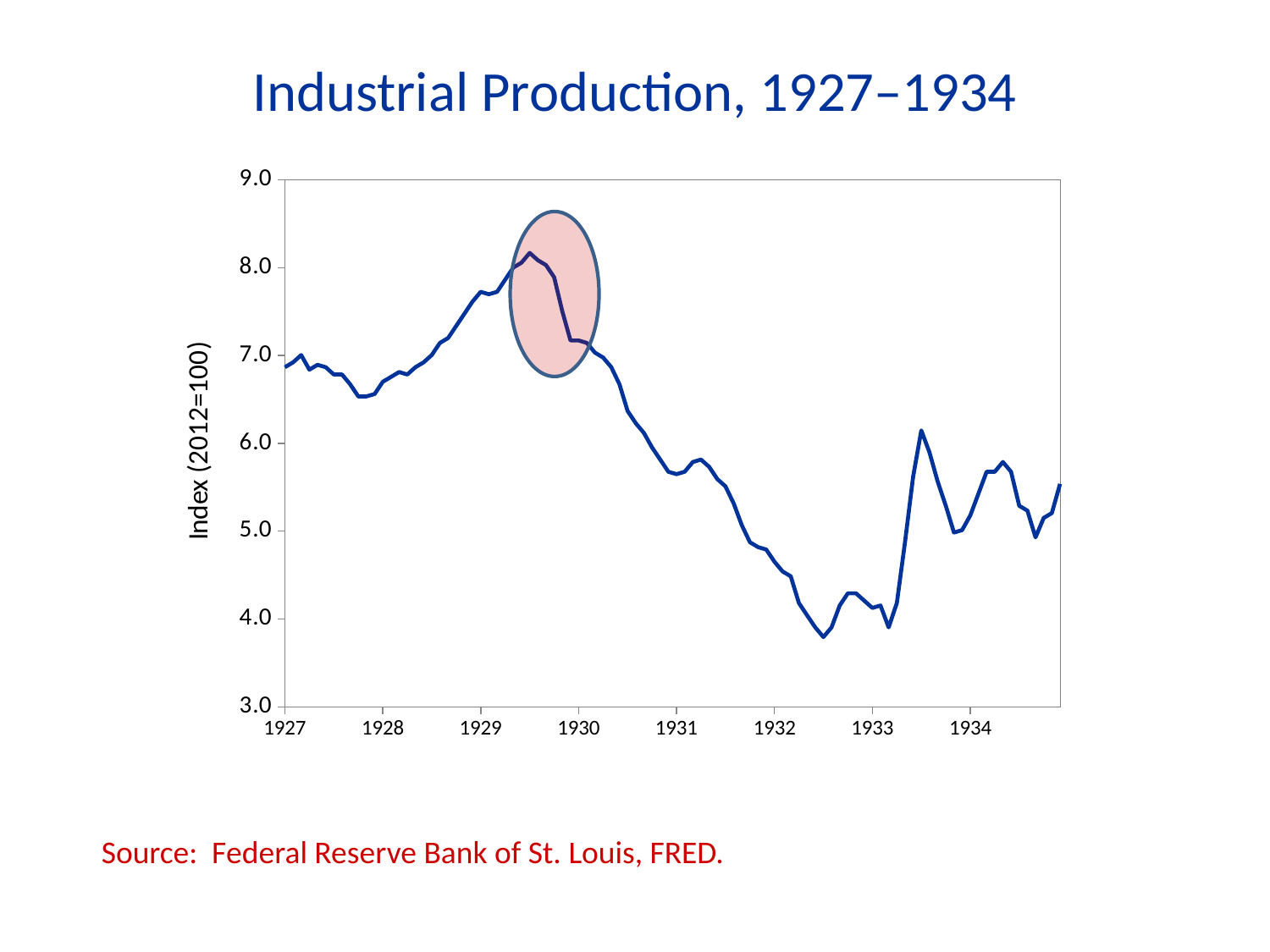
Is the value of the index at the start of 1928 greater or less than 7.0? less In which year does the industrial production index reach its lowest point? 1932 What is the title of the chart? Industrial Production, 1927–1934 Is the lowest value of the index in 1932 greater or less than 4.0? less Does the index rise or fall between 1929 and 1932? Fall Is the peak value of the index in 1929 greater or less than 8.0? greater In which year does the industrial production index reach its highest point? 1929 What is the label on the vertical axis of the chart? Index (2012=100) What kind of chart is shown on the slide? Line chart Which is larger, the index value at the start of 1928 or at the start of 1931? 1928